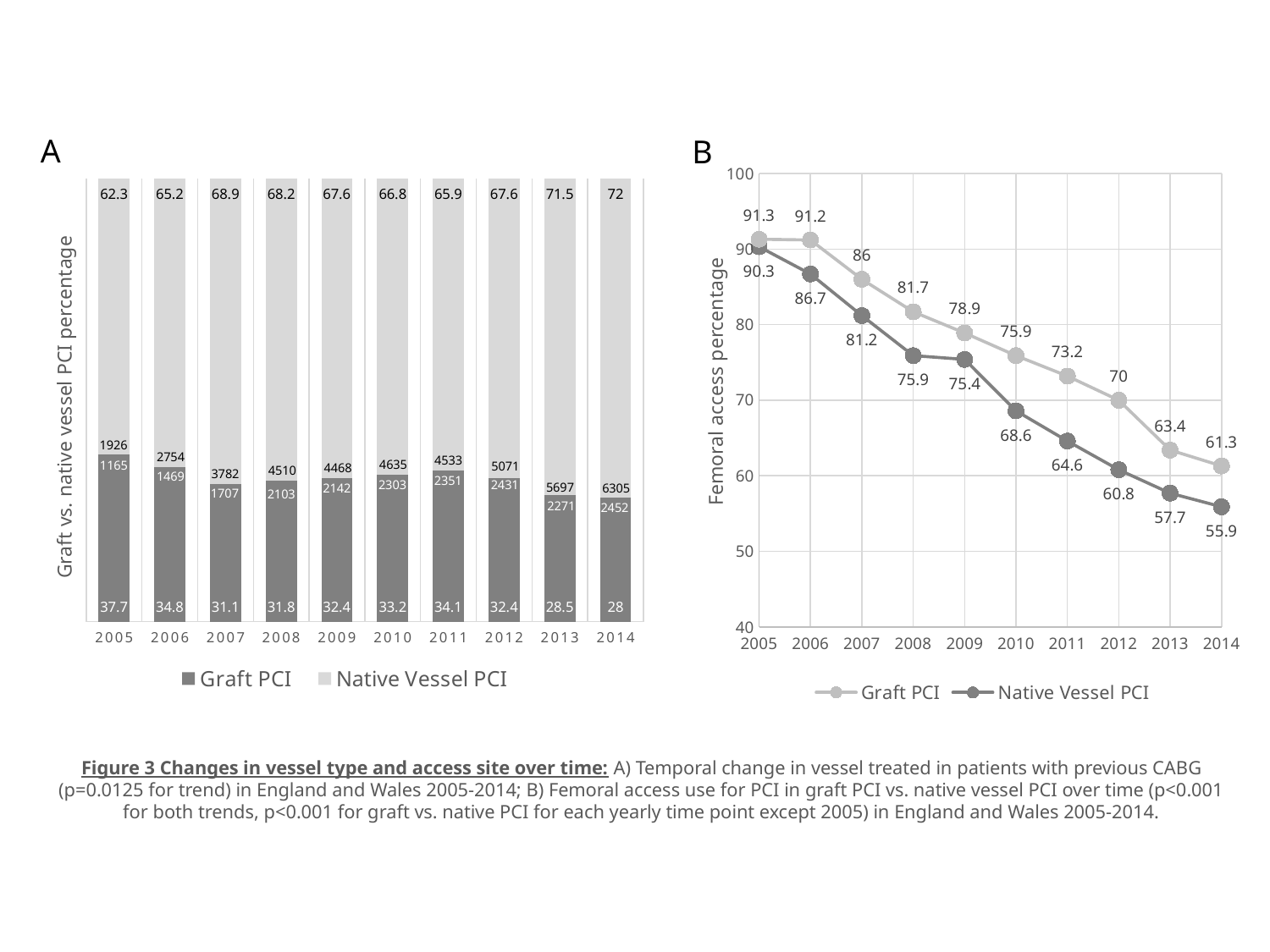
In chart A (Graft vs. native vessel PCI percentage), how many years are shown on the x axis? 10 In chart A (Graft vs. native vessel PCI percentage), what is the difference between the Native Vessel PCI and Graft PCI percentages in 2013? 43 In chart B (Femoral access percentage), what is the Native Vessel PCI value for 2014? 55.9 How many series does the legend of chart B (Femoral access percentage) list? 2 In chart B (Femoral access percentage), what is the difference between Graft PCI and Native Vessel PCI in 2012? 9.2 What type of chart is chart A (Graft vs. native vessel PCI percentage)? Stacked bar chart In chart B (Femoral access percentage), what is the Graft PCI value for 2009? 78.9 In chart A (Graft vs. native vessel PCI percentage), which year has the lowest Graft PCI percentage? 2014 In chart A (Graft vs. native vessel PCI percentage), which year has the highest Native Vessel PCI percentage? 2014 In chart A (Graft vs. native vessel PCI percentage), what is the Native Vessel PCI percentage for 2014? 72 In chart A (Graft vs. native vessel PCI percentage), what is the Graft PCI percentage for 2005? 37.7 In chart B (Femoral access percentage), does the Native Vessel PCI line rise or fall from 2005 to 2014? Fall